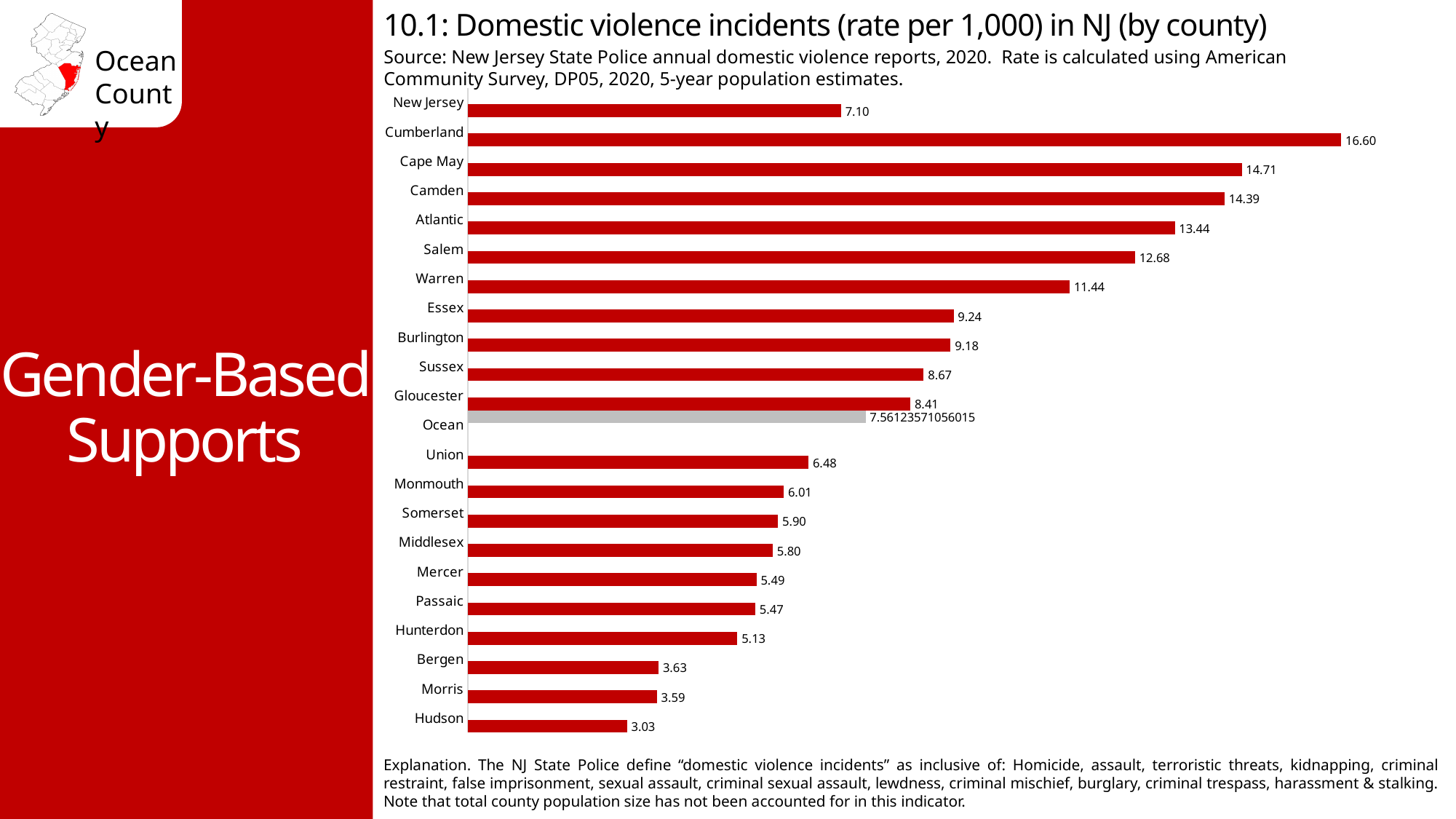
Which county has the lowest domestic violence incident rate? Hudson Which county has the highest domestic violence incident rate? Cumberland What is the difference between the rates for Cumberland and Hudson? 13.57 How many bars (categories) are shown in the chart? 22 What is the domestic violence incident rate per 1,000 for Cumberland County? 16.60 What is the rate shown for Hunterdon County? 5.13 What type of chart is shown on the slide? Bar chart What is the difference between the rates for Cape May and Camden? 0.32 Which has a higher rate, Salem or Warren? Salem Which county's bar is coloured grey instead of red? Ocean What value is printed for Ocean County? 7.56123571056015 What is the rate shown for New Jersey as a whole? 7.10